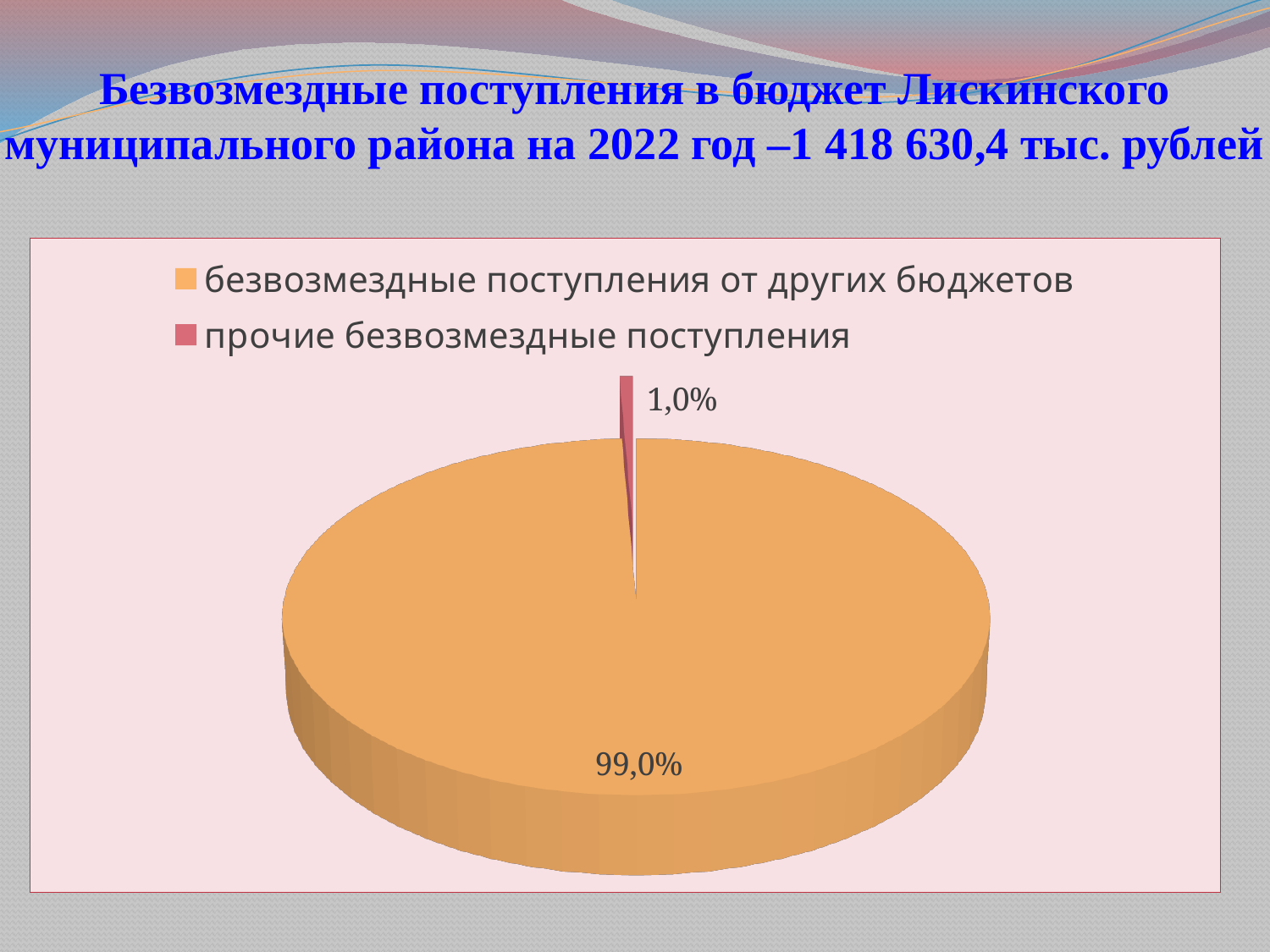
What share of the pie does 'безвозмездные поступления от других бюджетов' take? 99,0% What is the difference in percentage points between the shares of 'безвозмездные поступления от других бюджетов' and 'прочие безвозмездные поступления'? 98,0% Which is larger: the share of 'прочие безвозмездные поступления' or the share of 'безвозмездные поступления от других бюджетов'? безвозмездные поступления от других бюджетов How many entries does the legend list? 2 How many slices does the pie chart have? 2 Which category has the largest share of the pie? безвозмездные поступления от других бюджетов What share of the pie does 'прочие безвозмездные поступления' take? 1,0% Which category has the smallest share of the pie? прочие безвозмездные поступления What total amount of gratuitous receipts for 2022 is stated in the slide title? 1 418 630,4 тыс. рублей What colour is the slice for 'прочие безвозмездные поступления'? red What kind of chart is shown on the slide? pie chart